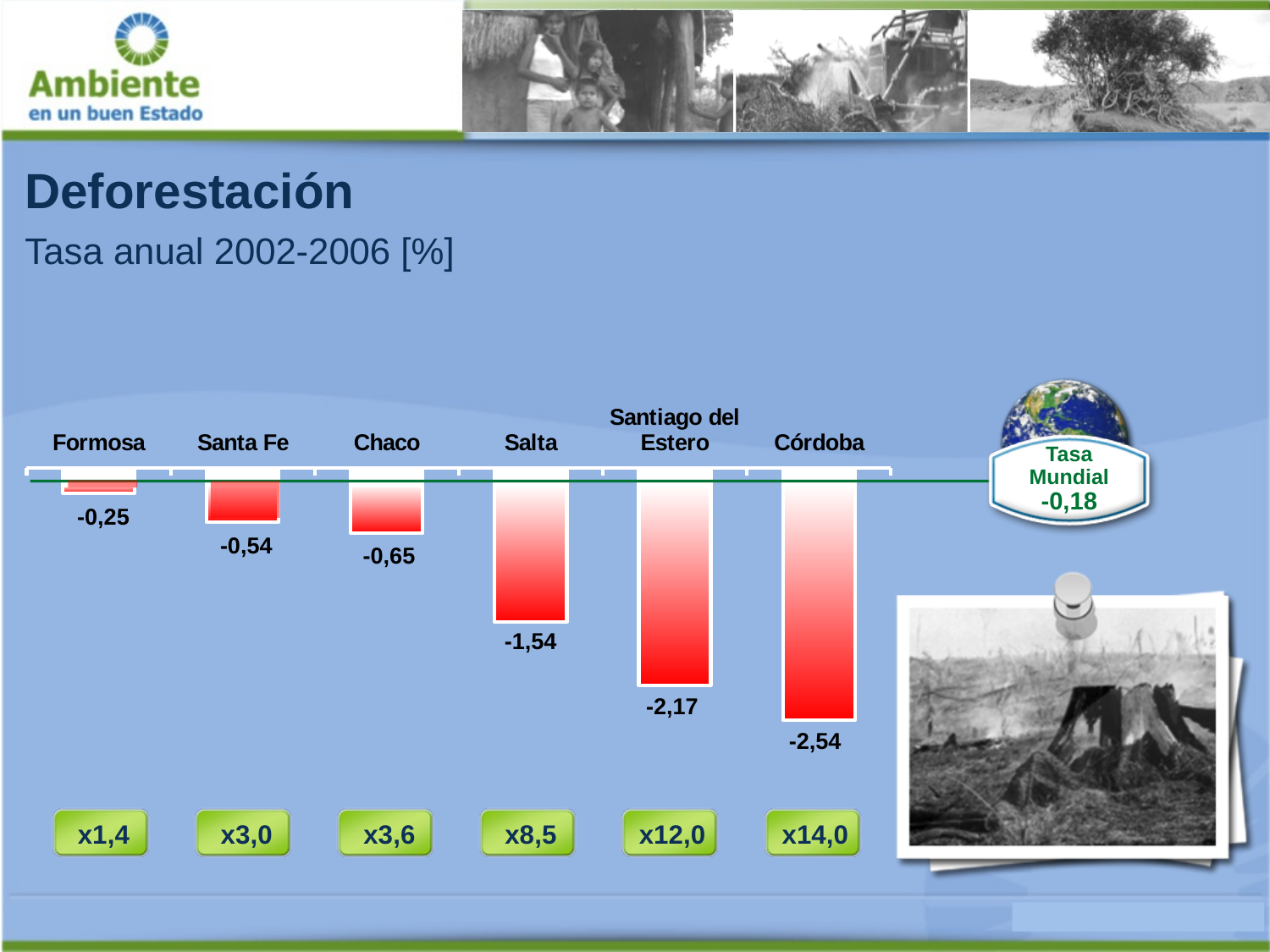
What value is shown for Santiago del Estero? -2,17 What is the annual deforestation rate shown for Salta? -1,54 By how much does the rate for Santiago del Estero differ from the rate for Salta? 0,63 How many provinces are plotted in the chart? 6 What kind of chart is shown on the slide? Bar chart What is the value labelled for Formosa? -0,25 What is the annual deforestation rate shown for Córdoba? -2,54 Which province has the smallest magnitude deforestation rate? Formosa What is the 'Tasa Mundial' (world rate) shown on the slide? -0,18 Which province has the most negative (largest magnitude) deforestation rate? Córdoba By how much does the rate for Córdoba differ from the rate for Formosa? 2,29 Which has a larger magnitude deforestation rate, Chaco or Santa Fe? Chaco